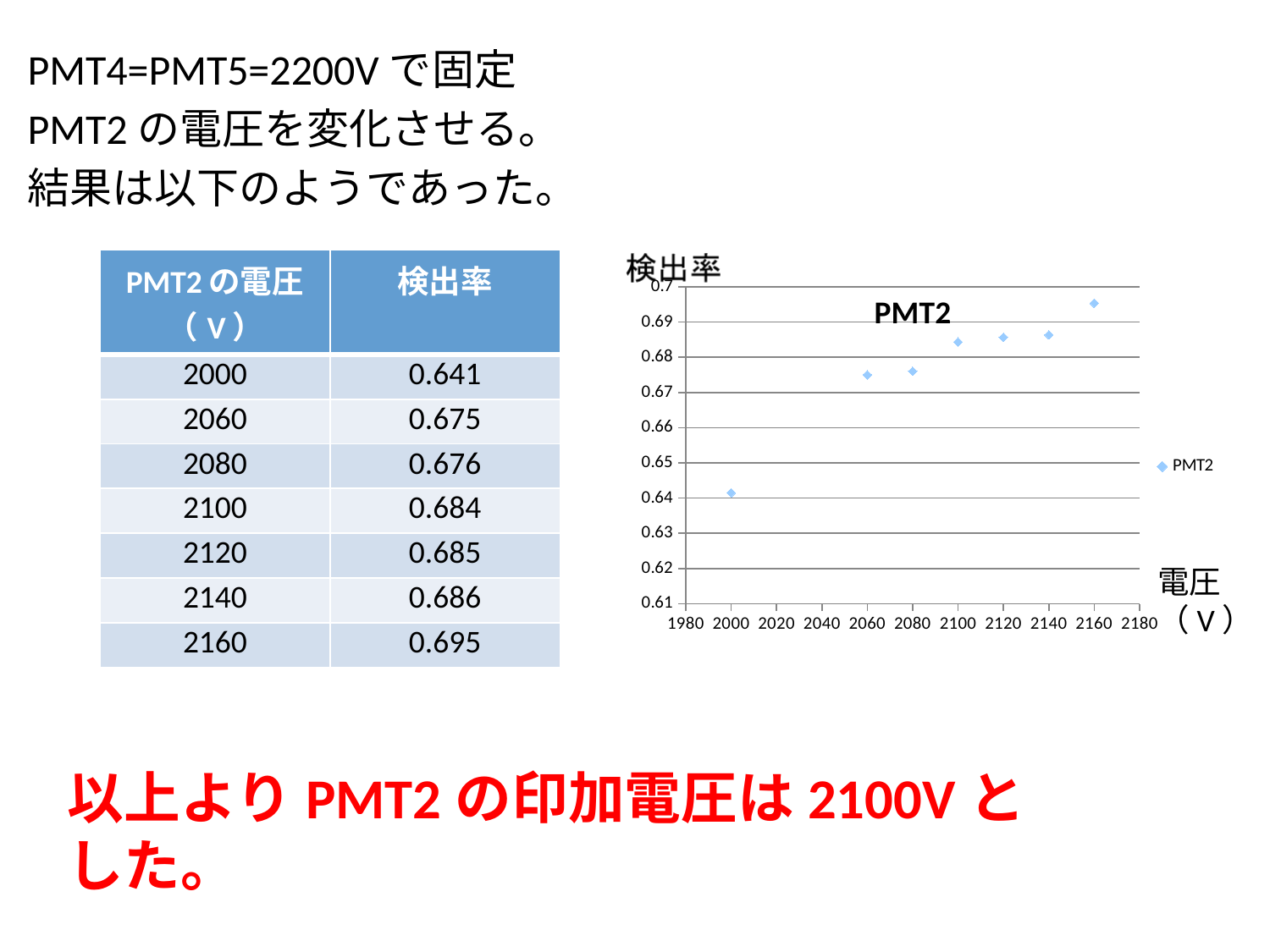
What is the title of the chart? PMT2 In the PMT2 chart, is the value at 2000 V greater or less than 0.65? less How many data points are plotted in the PMT2 chart? 7 How many series does the legend of the PMT2 chart list? 1 At which voltage is the detection rate (検出率) highest in the PMT2 chart? 2160 What is the difference between the detection rate at 2160 V and at 2000 V? 0.054 What kind of chart is shown on the slide? scatter chart In the PMT2 chart, is the value at 2160 V greater or less than 0.69? greater Do the detection rate values in the PMT2 chart rise or fall as the voltage increases? rise What is the detection rate (検出率) at 2100 V? 0.684 Which has the larger detection rate in the PMT2 chart, 2060 V or 2100 V? 2100 V At which voltage is the detection rate (検出率) lowest in the PMT2 chart? 2000